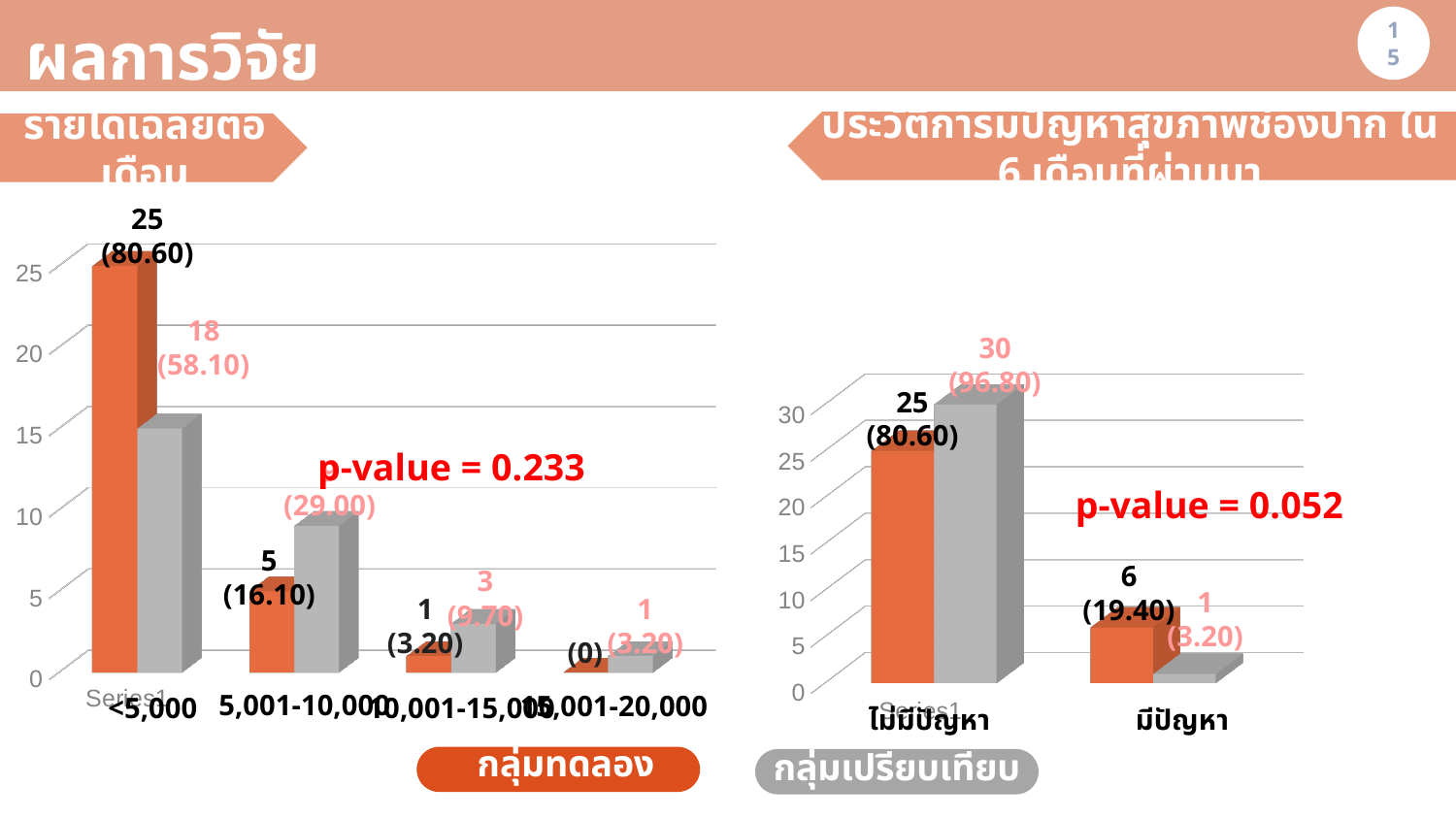
On the left chart, what percentage is shown in parentheses for the gray bar in the <5,000 category? 58.10 On the right chart, what is the value of the gray bar for ไม่มีปัญหา? 30 On the left chart, what is the value of the orange bar for the 5,001-10,000 category? 5 On the left chart, what is the value of the orange bar for the <5,000 category? 25 On the right chart, what is the value of the orange bar for มีปัญหา? 6 On the left chart, how many income categories are shown on the x axis? 4 On the left chart, what p-value is displayed? 0.233 On the right chart, for the ไม่มีปัญหา category, which bar is larger, the orange or the gray? gray What type of chart is shown on the right side of the slide? bar chart On the right chart, what is the difference between the orange and gray bar values for มีปัญหา? 5 On the left chart, which category has the highest orange bar? <5,000